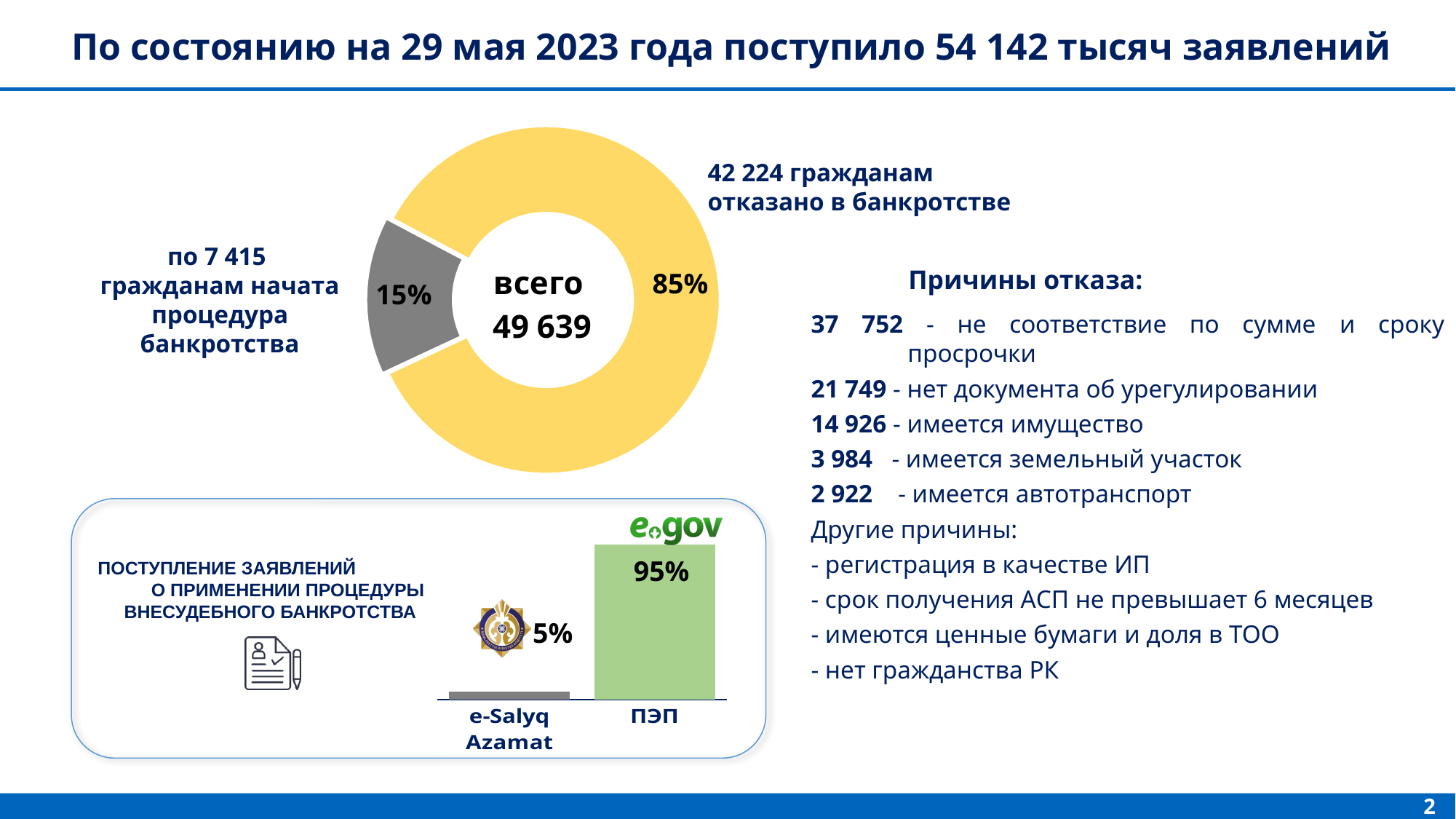
In the donut chart at the top of the slide, what share is shown for the yellow slice? 85% In the bar chart at the bottom left of the slide, what is the value for 'ПЭП'? 95% What kind of chart is the chart at the top of the slide with the label 'всего 49 639' in the centre? pie chart (donut) In the bar chart at the bottom left of the slide, what is the value for 'e-Salyq Azamat'? 5% In the donut chart at the top of the slide, what total is printed in the centre? 49 639 In the donut chart at the top of the slide, how many slices are there? 2 In the donut chart at the top of the slide, which slice is larger, the grey one (15%) or the yellow one (85%)? the yellow one (85%) In the bar chart at the bottom left of the slide, how many categories are shown? 2 What kind of chart is the chart in the box at the bottom left of the slide with categories 'e-Salyq Azamat' and 'ПЭП'? bar chart In the bar chart at the bottom left of the slide, which category has the highest value? ПЭП In the donut chart at the top of the slide, what is the difference in percentage points between the 85% slice and the 15% slice? 70 percentage points In the donut chart at the top of the slide, what share is shown for the grey slice? 15%